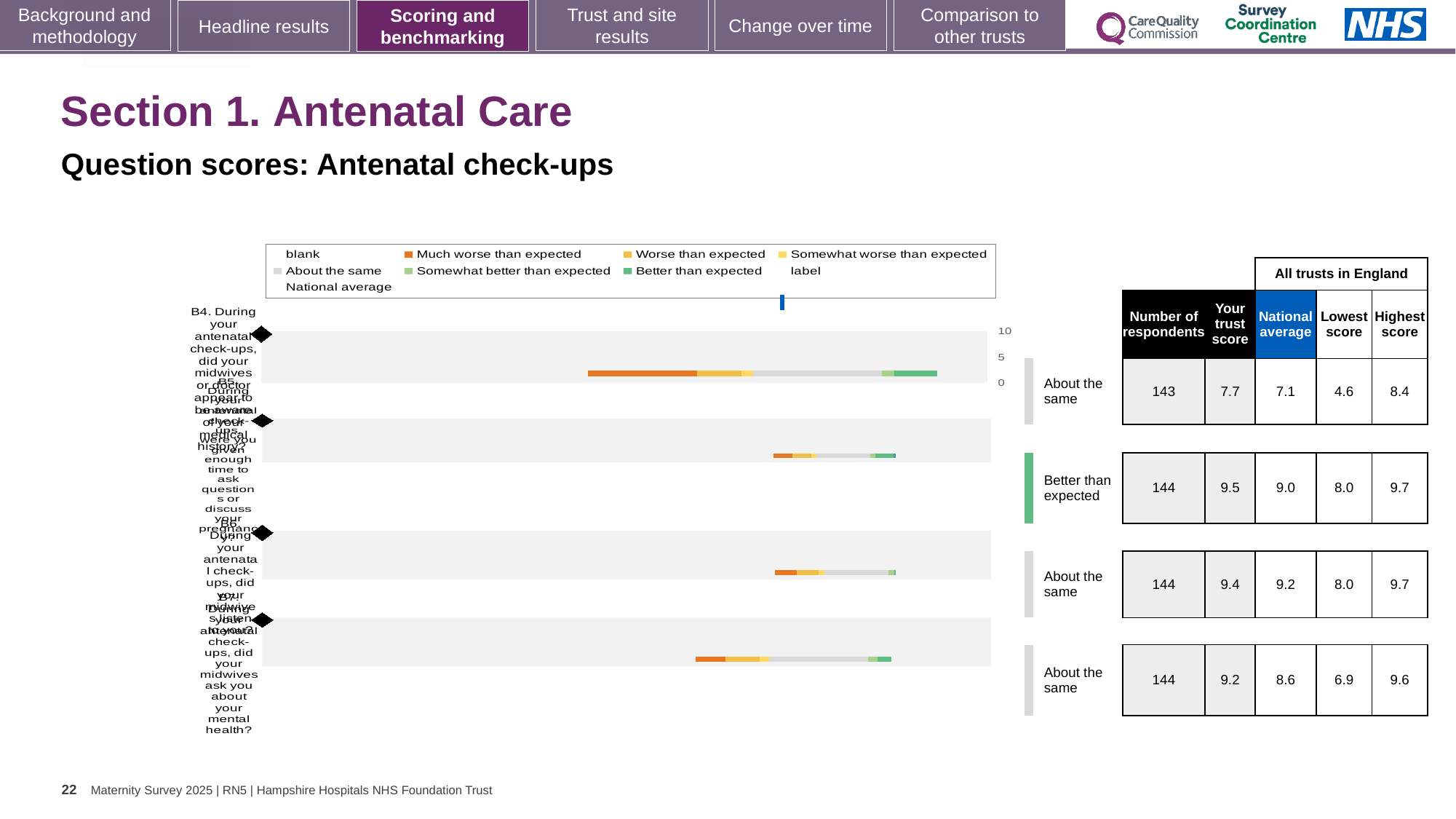
What is the 'Your trust score' for the top row (B4) in the table beside the chart? 7.7 Which row in the table has the lowest 'Your trust score'? the top row (B4), 7.7 Which row in the table has the highest 'Your trust score'? the second row (Better than expected), 9.5 How many survey questions (bars) are plotted in the chart? 4 How many respondents are listed for the top row (B4)? 143 What is the national average for the top row (B4) in the table beside the chart? 7.1 What is the highest score among all trusts in England for the second row? 9.7 What colour does the legend use for 'Much worse than expected'? orange For the bottom row, is the trust score (9.2) larger or smaller than the national average (8.6)? larger What is the difference between the highest trust score (9.5) and the lowest trust score (7.7) in the table? 1.8 What is the subtitle describing the chart's content? Question scores: Antenatal check-ups What kind of chart is shown on the slide? bar chart